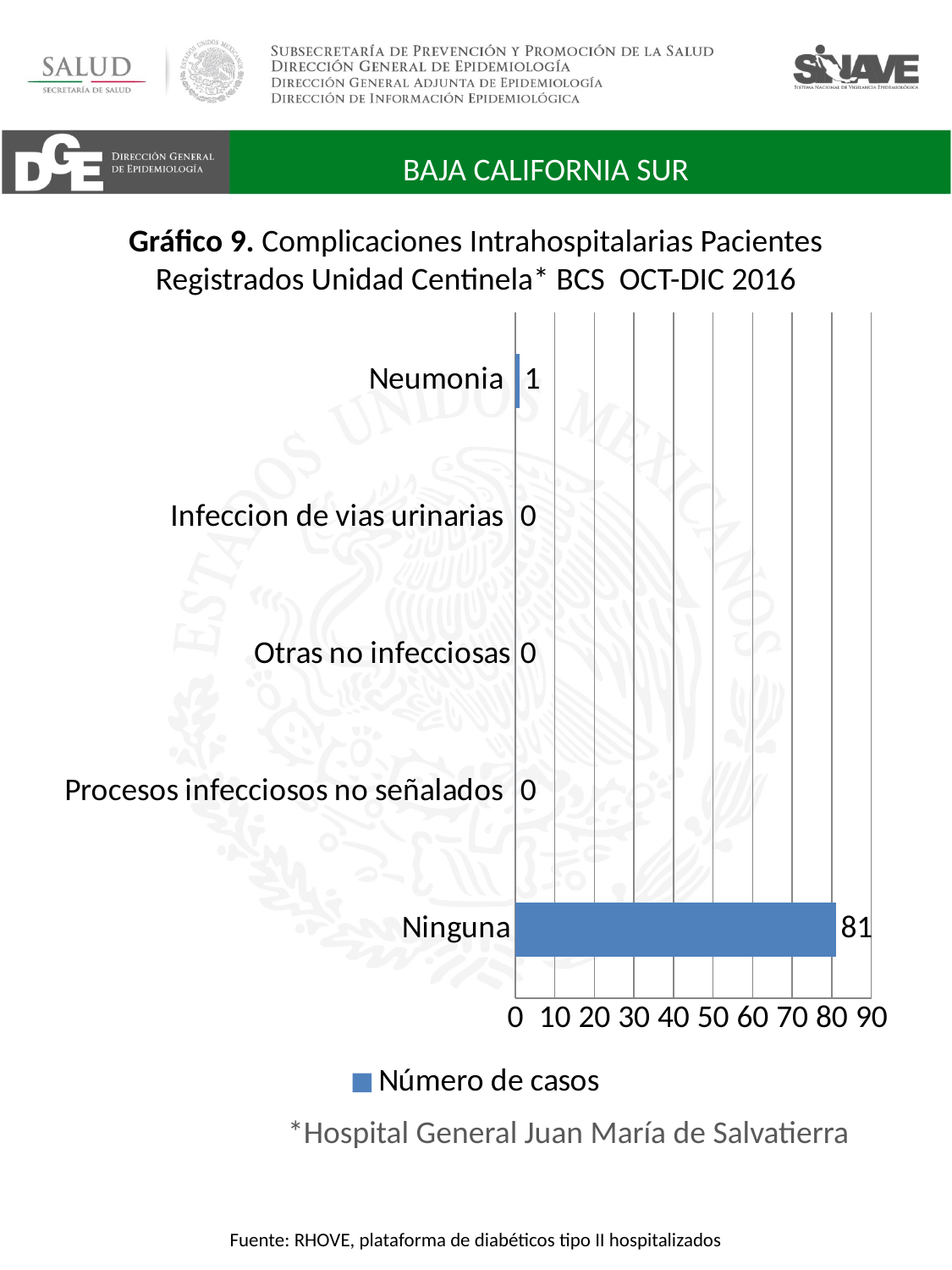
What is the difference in number of cases between Ninguna and Neumonia? 80 What is the legend entry of the chart? Número de casos Is the value for Ninguna greater or less than 50? greater How many categories are shown in the chart? 5 What is the number of cases for Neumonia? 1 Which category has the highest number of cases? Ninguna Which has more cases, Neumonia or Otras no infecciosas? Neumonia What is the number of cases for Ninguna? 81 What is the number of cases for Infeccion de vias urinarias? 0 What is the number of cases for Procesos infecciosos no señalados? 0 What kind of chart is shown on the slide? Bar chart How many series does the legend list? 1